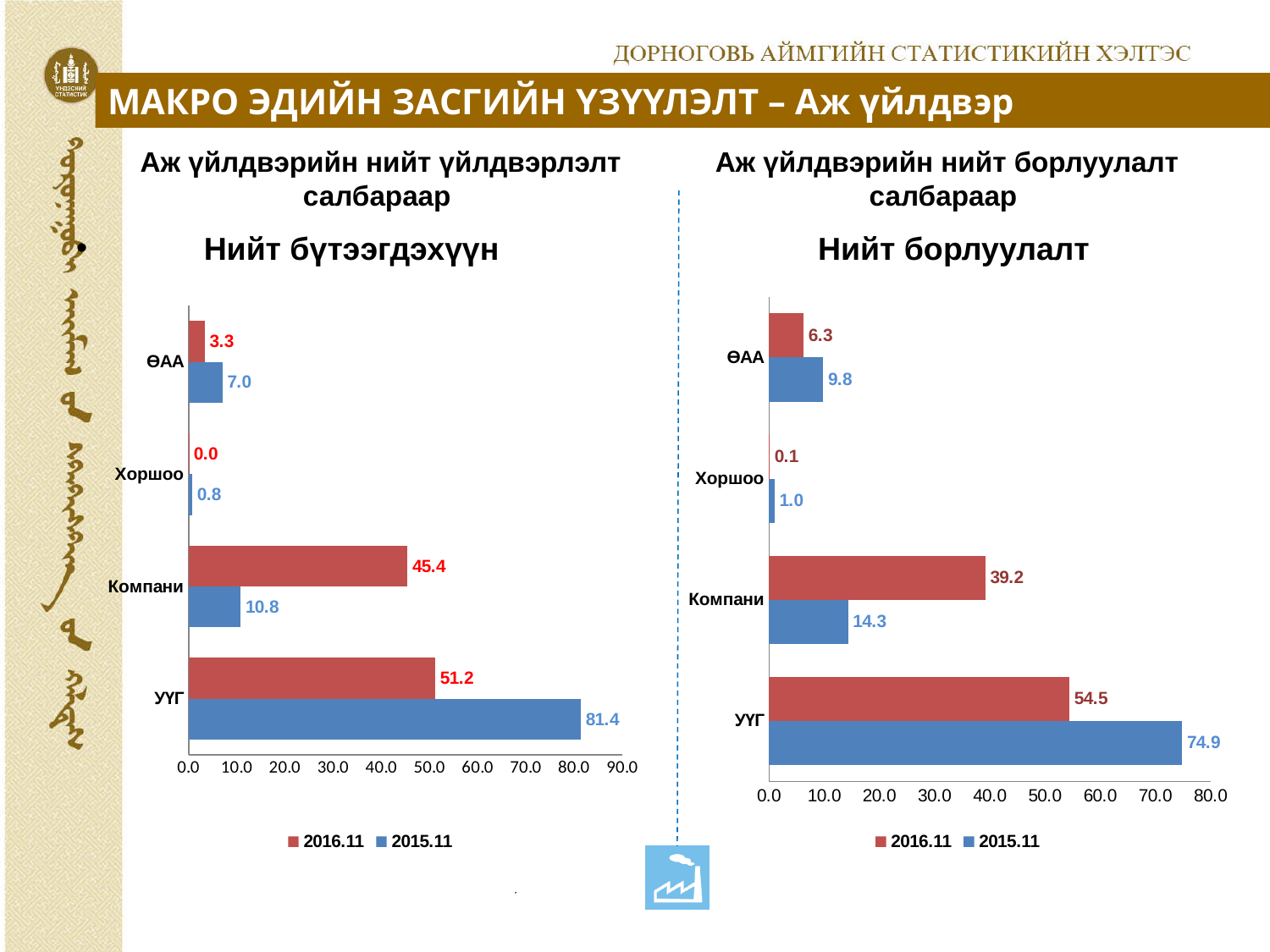
In the 'Нийт бүтээгдэхүүн' chart on the left, what is the value for УҮГ in 2015.11? 81.4 In the 'Нийт бүтээгдэхүүн' chart on the left, is the 2016.11 value for Компани greater or less than 40.0? greater In the 'Нийт борлуулалт' chart on the right, which category has the lowest value for 2015.11? Хоршоо In the 'Нийт борлуулалт' chart on the right, what is the value for Компани in 2016.11? 39.2 In the 'Нийт борлуулалт' chart on the right, which is larger for ӨАА: the 2016.11 value or the 2015.11 value? 2015.11 In the 'Нийт бүтээгдэхүүн' chart on the left, which category has the highest value for 2016.11? УҮГ How many categories are shown in the 'Нийт борлуулалт' chart on the right? 4 In the 'Нийт борлуулалт' chart on the right, what is the difference between the 2016.11 and 2015.11 values for Компани? 24.9 How many series does the legend of the 'Нийт бүтээгдэхүүн' chart on the left list? 2 What type of chart is the 'Нийт борлуулалт' chart on the right? Bar chart In the 'Нийт бүтээгдэхүүн' chart on the left, what is the difference between the 2015.11 and 2016.11 values for УҮГ? 30.2 In the 'Нийт бүтээгдэхүүн' chart on the left, which series is shown in red? 2016.11